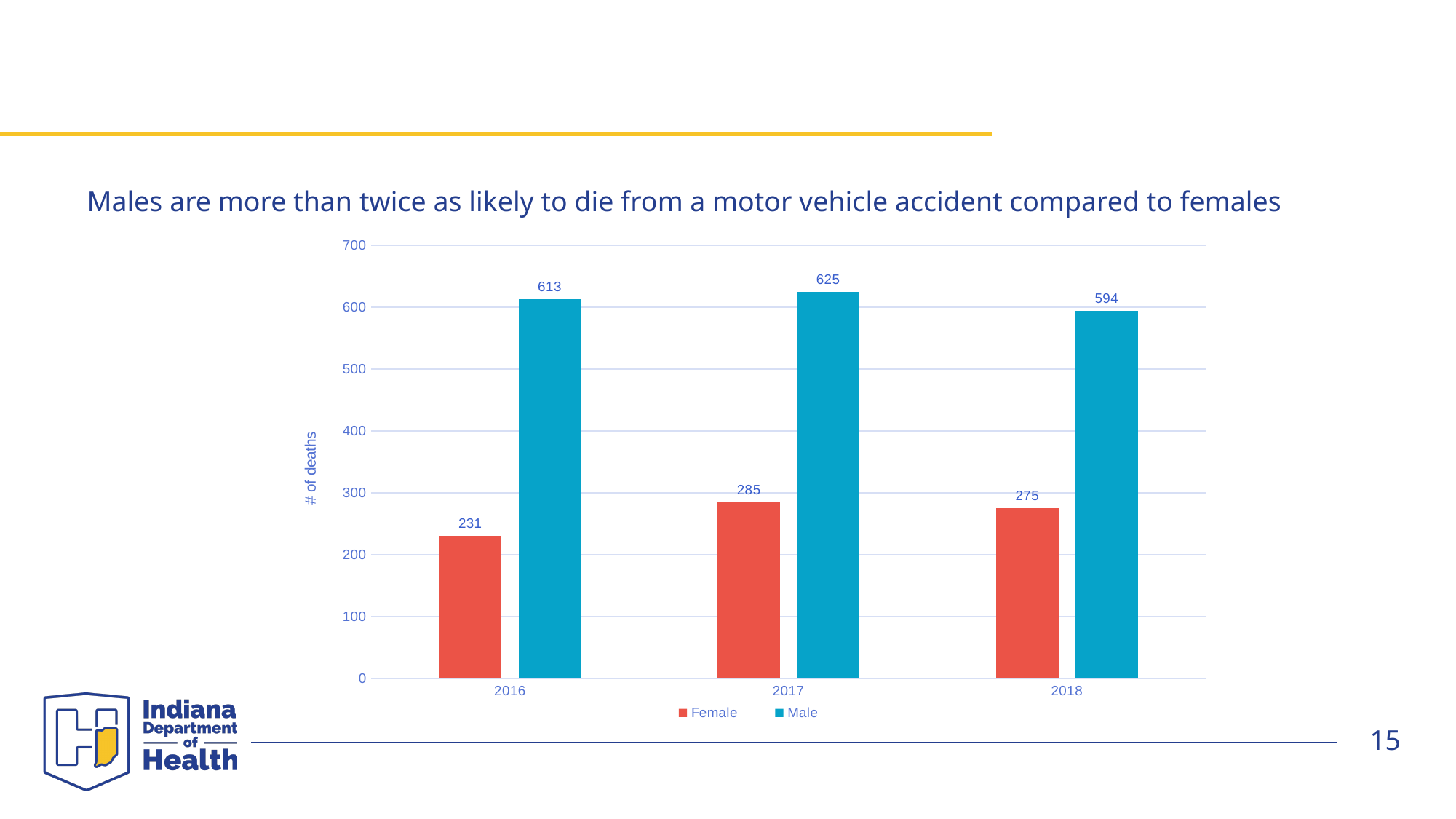
What is the difference between male and female deaths in 2016? 382 What is the number of male deaths shown for 2017? 625 What is the number of female deaths shown for 2018? 275 How many series does the legend list? 2 How many years are shown on the x axis? 3 In which year was the number of female deaths lowest? 2016 By how much did male deaths fall from 2017 to 2018? 31 What is the label on the vertical axis? # of deaths In which year was the number of male deaths highest? 2017 How many motor vehicle accident deaths were there among females in 2016? 231 Which is larger, female deaths in 2017 or female deaths in 2018? 2017 What kind of chart is shown on the slide? Bar chart